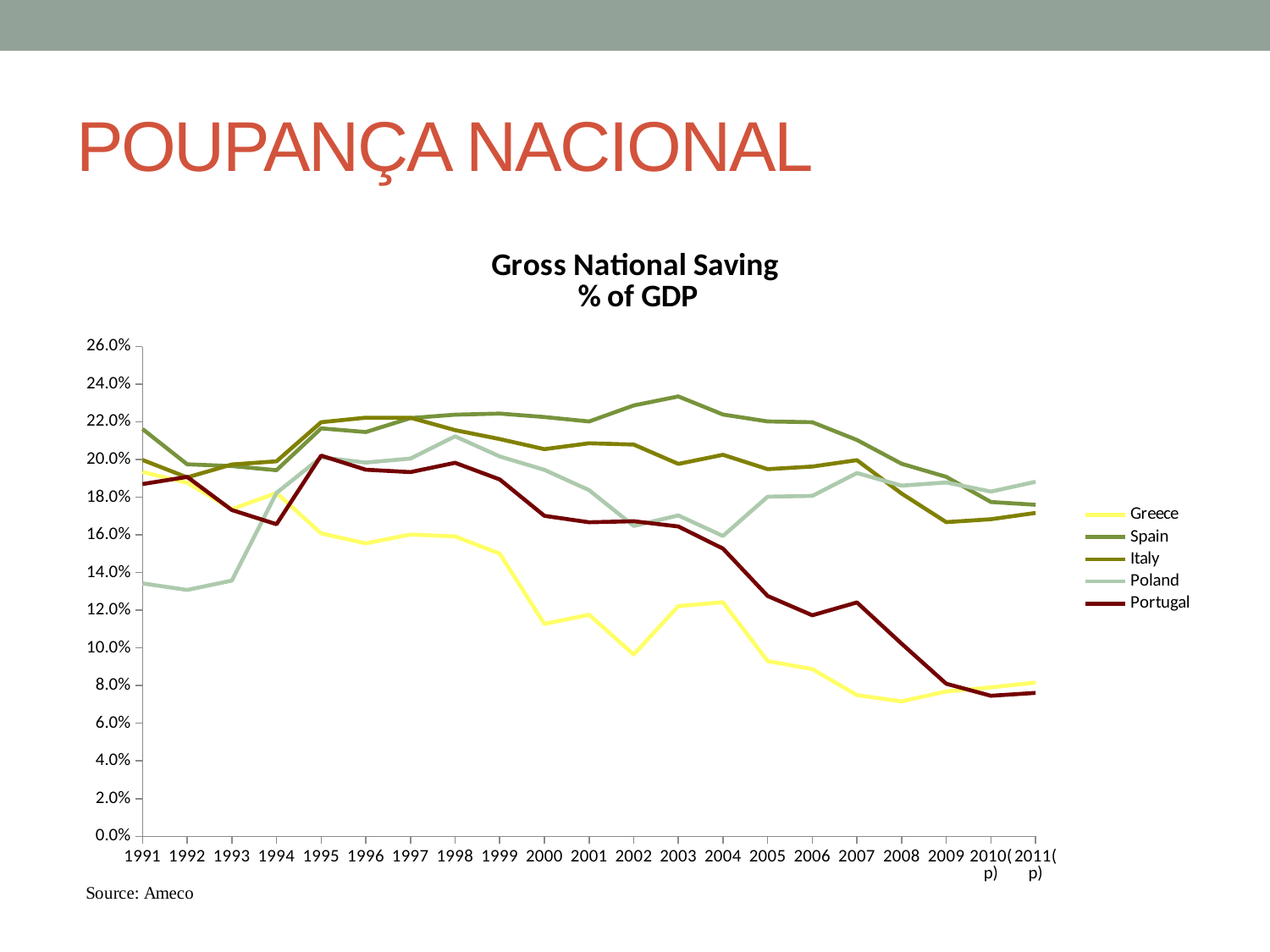
Is the value for Greece in 2002 greater or less than 10.0%? less What kind of chart is shown on the slide? Line chart In 2005, which is larger: the value for Italy or the value for Portugal? Italy Which country has the lowest gross national saving in 2008? Greece Is the value for Poland in 1992 greater or less than 14.0%? less Is the value for Spain in 2003 greater or less than 22.0%? greater How many years are shown along the x axis? 21 Which country has the highest gross national saving in 2003? Spain Does the value for Portugal rise or fall from 2004 to 2010? Fall How many series does the legend list? 5 What is the title of the chart? Gross National Saving % of GDP